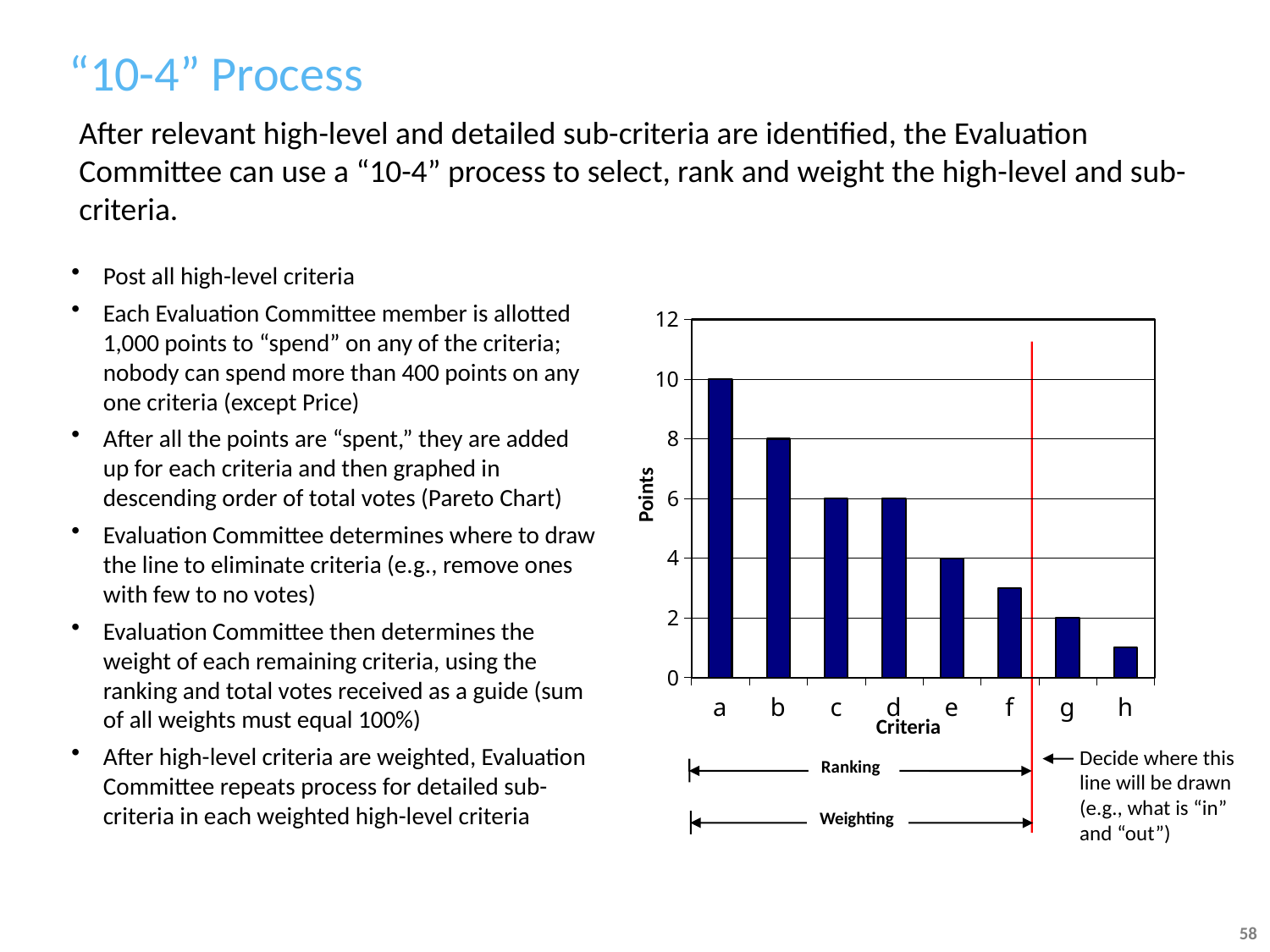
What is the value for criterion e? 4 Which criterion has the lowest value? h What is the value for criterion a? 10 Is the value for criterion f greater or less than 4? less How many criteria are plotted on the x axis of the chart? 8 What type of chart is shown on the slide? bar chart Which criterion has the highest value? a What is the difference between the values for criteria a and b? 2 What is the value for criterion b? 8 What is the value for criterion g? 2 What is the label of the vertical axis of the chart? Points Do the values rise or fall from left to right along the x axis? fall